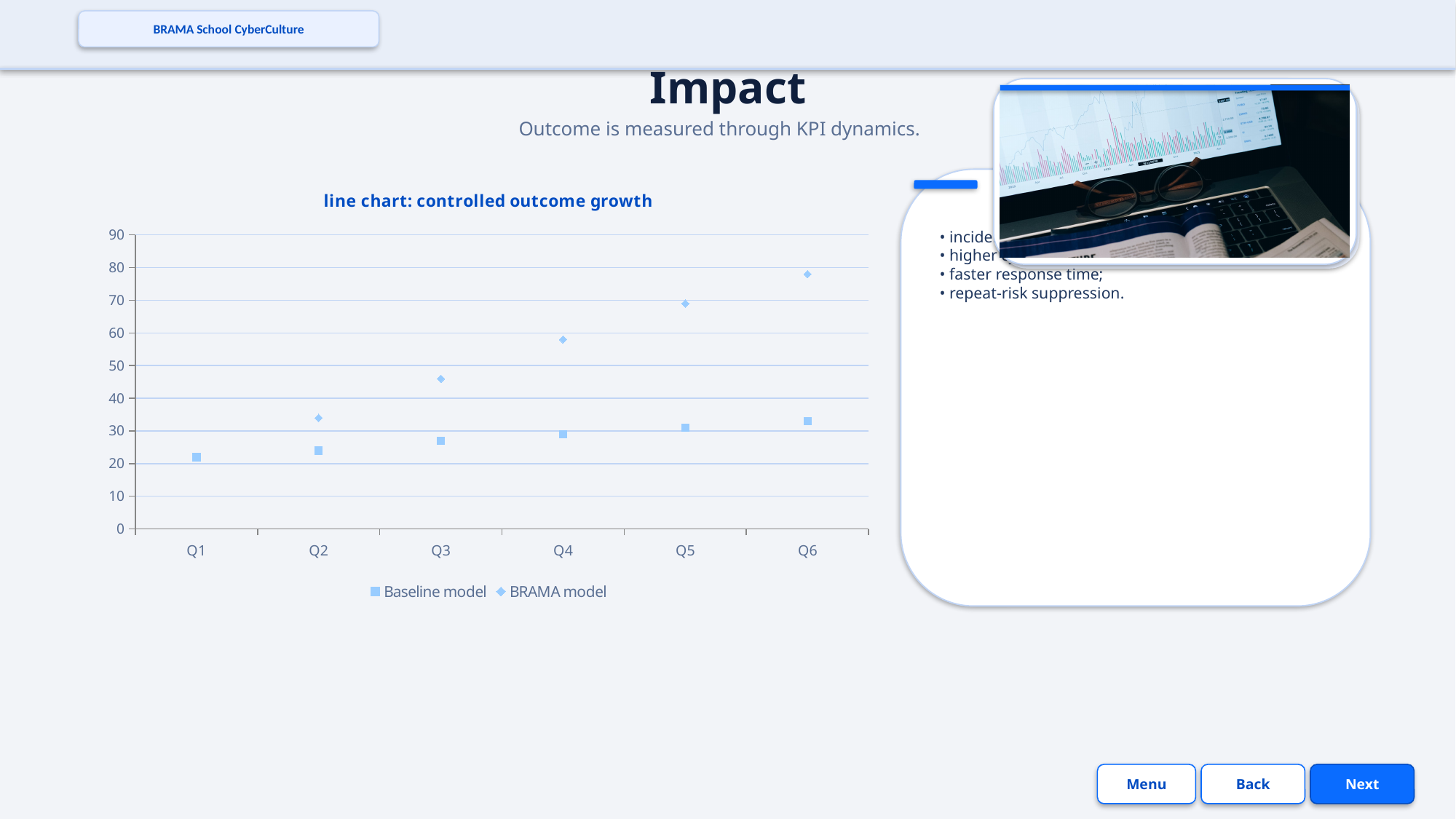
Is the BRAMA model value for Q6 greater or less than 70? greater Is the BRAMA model value for Q4 greater or less than 50? greater Is the BRAMA model value for Q3 greater or less than 50? less How many quarters are shown on the x axis of the chart? 6 Do the BRAMA model values rise or fall from Q2 to Q6? rise How many series does the chart legend list? 2 In which quarter does the BRAMA model reach its highest value? Q6 What are the two series named in the legend? Baseline model and BRAMA model What is the title of the chart? line chart: controlled outcome growth At Q5, which series has the larger value, Baseline model or BRAMA model? BRAMA model In which quarter is the Baseline model value lowest? Q1